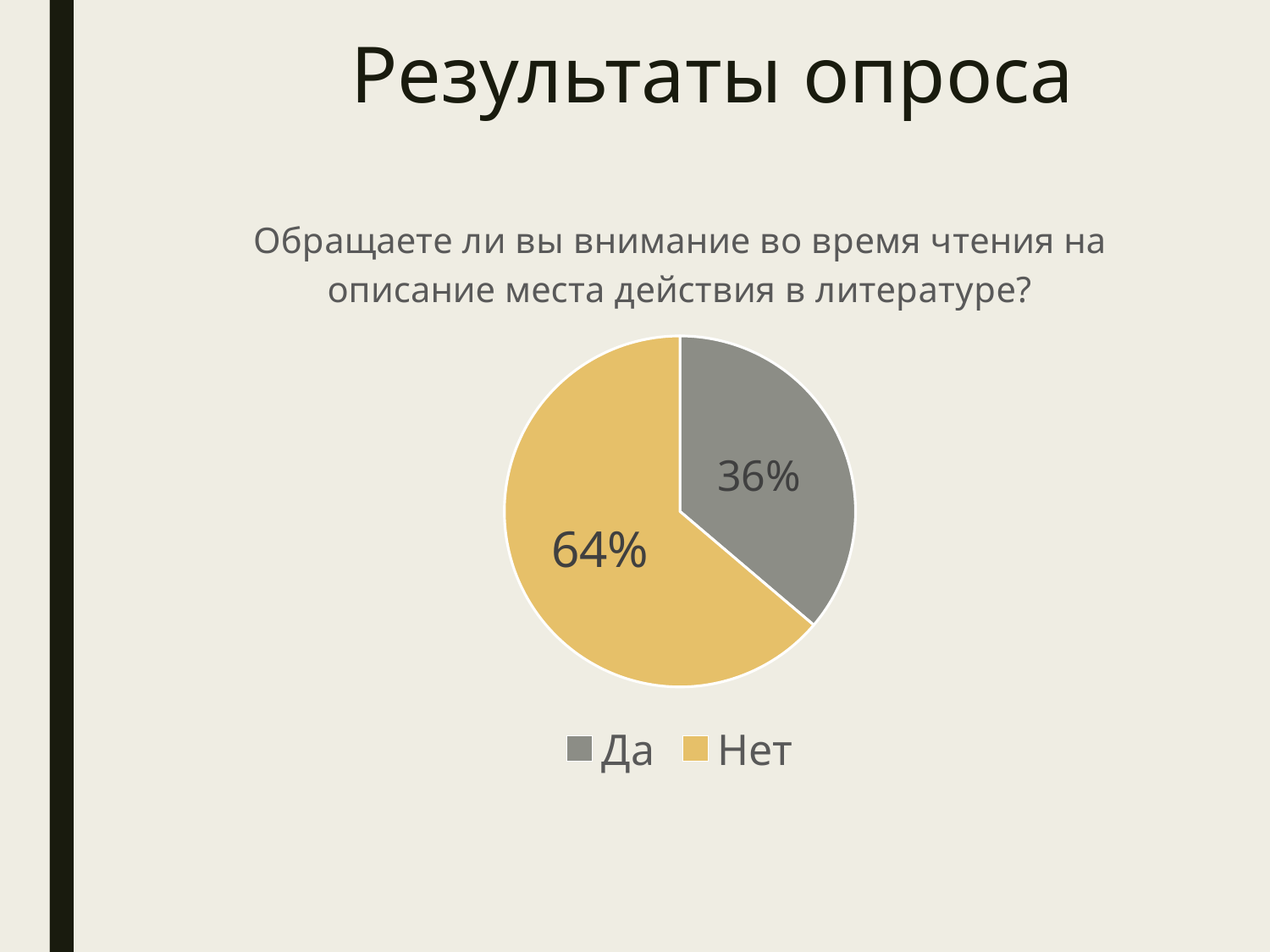
Which answer has the smallest share of the pie? Да What type of chart is shown on the slide? Pie chart What percentage of respondents answered "Нет"? 64% How many slices does the pie chart have? 2 Which slice is larger, "Да" or "Нет"? Нет What share of the pie does the "Да" slice represent? 36% What percentage of respondents answered "Да"? 36% Which colour represents "Нет" in the pie chart? Yellow What is the title of the chart? Обращаете ли вы внимание во время чтения на описание места действия в литературе? What is the difference in percentage points between the "Нет" and "Да" slices? 28 How many entries does the legend list? 2 Which answer has the largest share of the pie? Нет